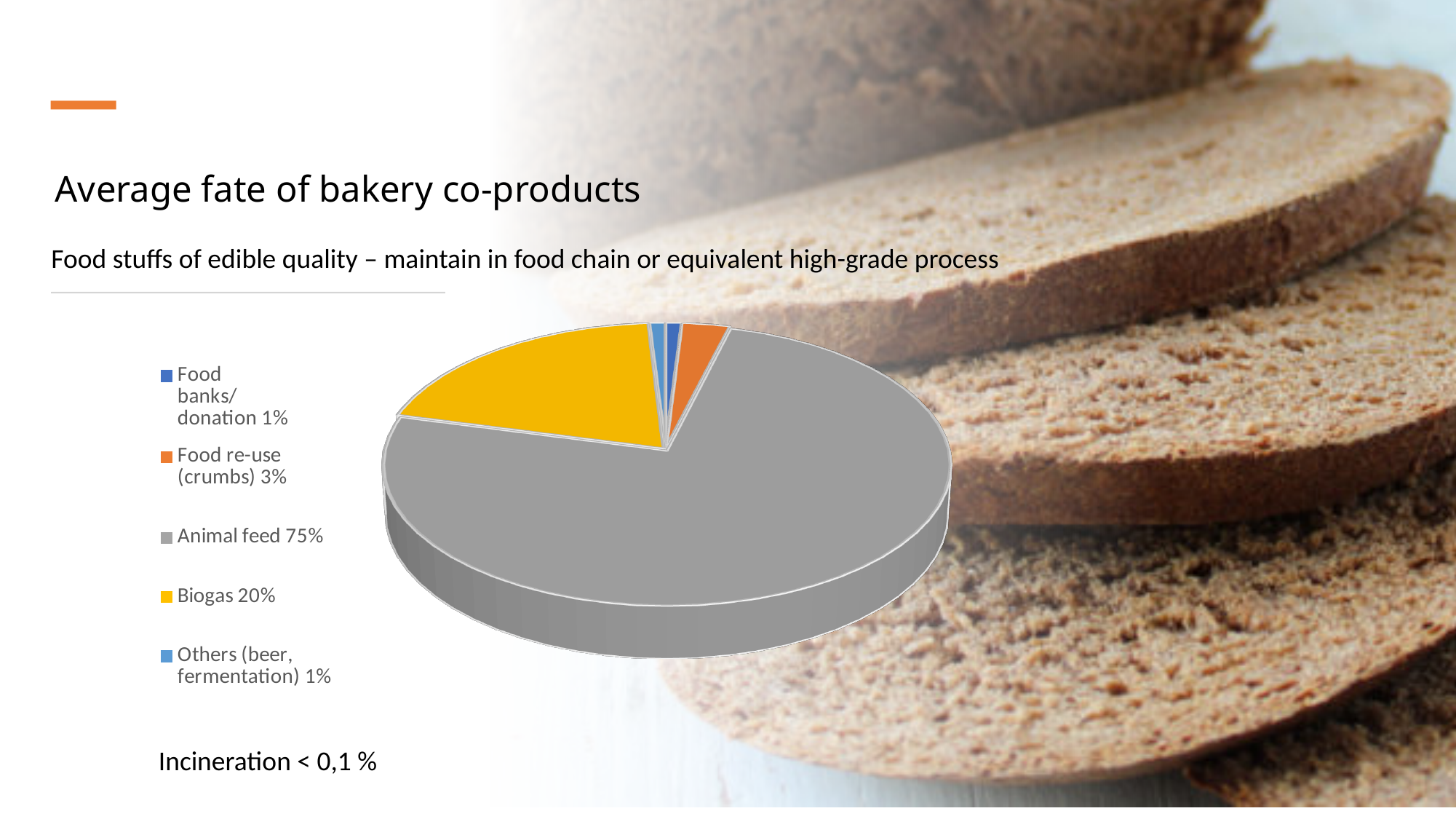
How many categories does the legend list? 5 Which is larger, the share for biogas or the share for food re-use (crumbs)? Biogas What share of bakery co-products goes to others (beer, fermentation)? 1% What colour represents animal feed in the pie chart? Grey What share of bakery co-products goes to food banks/donation? 1% Which category has the largest share of the pie? Animal feed What kind of chart is shown on the slide? Pie chart What share of bakery co-products goes to animal feed? 75% What is the title of the slide containing the chart? Average fate of bakery co-products What share of bakery co-products goes to biogas? 20% What share of bakery co-products goes to food re-use (crumbs)? 3% What is the difference in percentage points between animal feed and biogas? 55